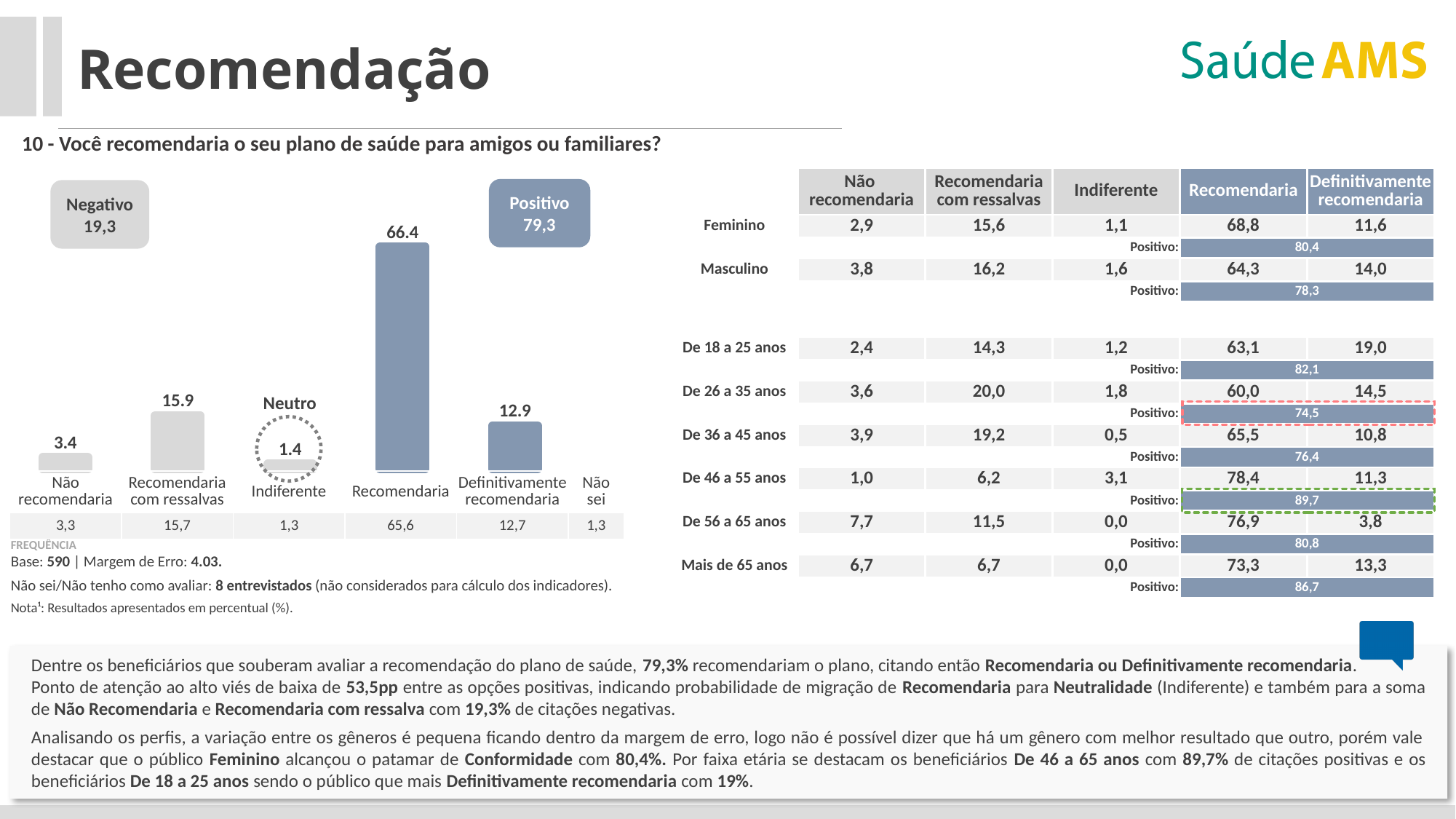
What is the value shown for Não recomendaria in the bar chart? 3.4 What is the value shown for Recomendaria com ressalvas in the bar chart? 15.9 Which is larger in the bar chart: Recomendaria com ressalvas or Definitivamente recomendaria? Recomendaria com ressalvas What is the difference between the values for Recomendaria and Definitivamente recomendaria in the bar chart? 53.5 What value is shown in the 'Negativo' box above the bar chart? 19,3 What is the value shown for Definitivamente recomendaria in the bar chart? 12.9 Which category has the highest value in the bar chart? Recomendaria What is the value shown for Recomendaria in the bar chart? 66.4 What value is shown in the 'Positivo' box above the bar chart? 79,3 What is the value shown for Indiferente in the bar chart? 1.4 Which category has the lowest value in the bar chart? Indiferente What type of chart is shown on the left of the slide? Bar chart